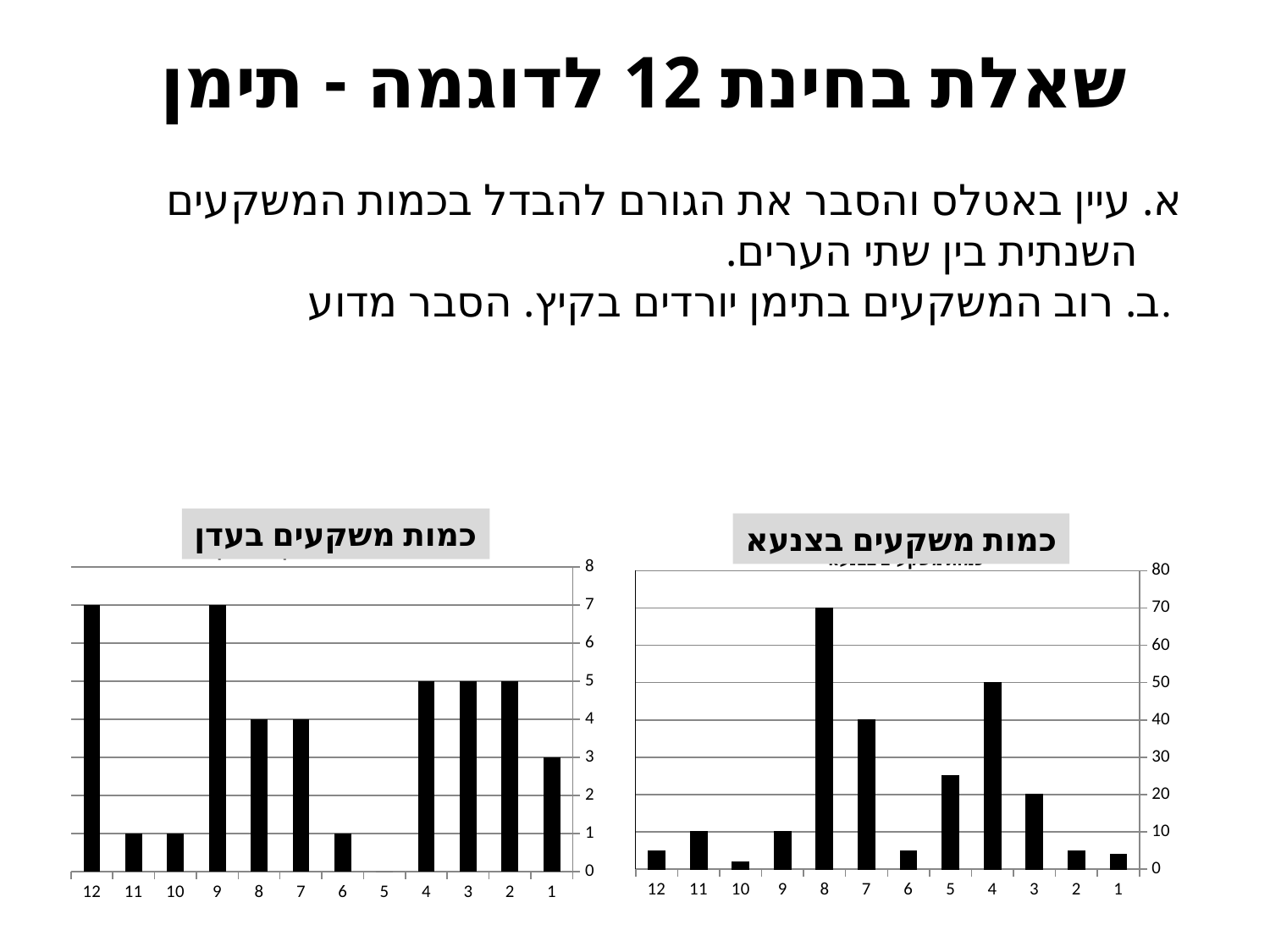
In the chart titled כמות משקעים בצנעא, is the value for month 12 greater or less than 10? less In the chart titled כמות משקעים בעדן, what is the difference between the value for month 12 and the value for month 1? 4 In the chart titled כמות משקעים בעדן, what is the value for month 8? 4 In the chart titled כמות משקעים בעדן, which month has the lowest value? 5 In the chart titled כמות משקעים בעדן, how many months are shown on the x axis? 12 In the chart titled כמות משקעים בעדן, which is larger, the value for month 4 or the value for month 6? month 4 In the chart titled כמות משקעים בצנעא, which month has the highest value? 8 In the chart titled כמות משקעים בצנעא, which is larger, the value for month 7 or the value for month 3? month 7 What kind of chart is the chart titled כמות משקעים בעדן? bar chart In the chart titled כמות משקעים בצנעא, what is the value for month 8? 70 In the chart titled כמות משקעים בעדן, what is the value for month 1? 3 In the chart titled כמות משקעים בצנעא, what is the difference between the value for month 8 and the value for month 4? 20